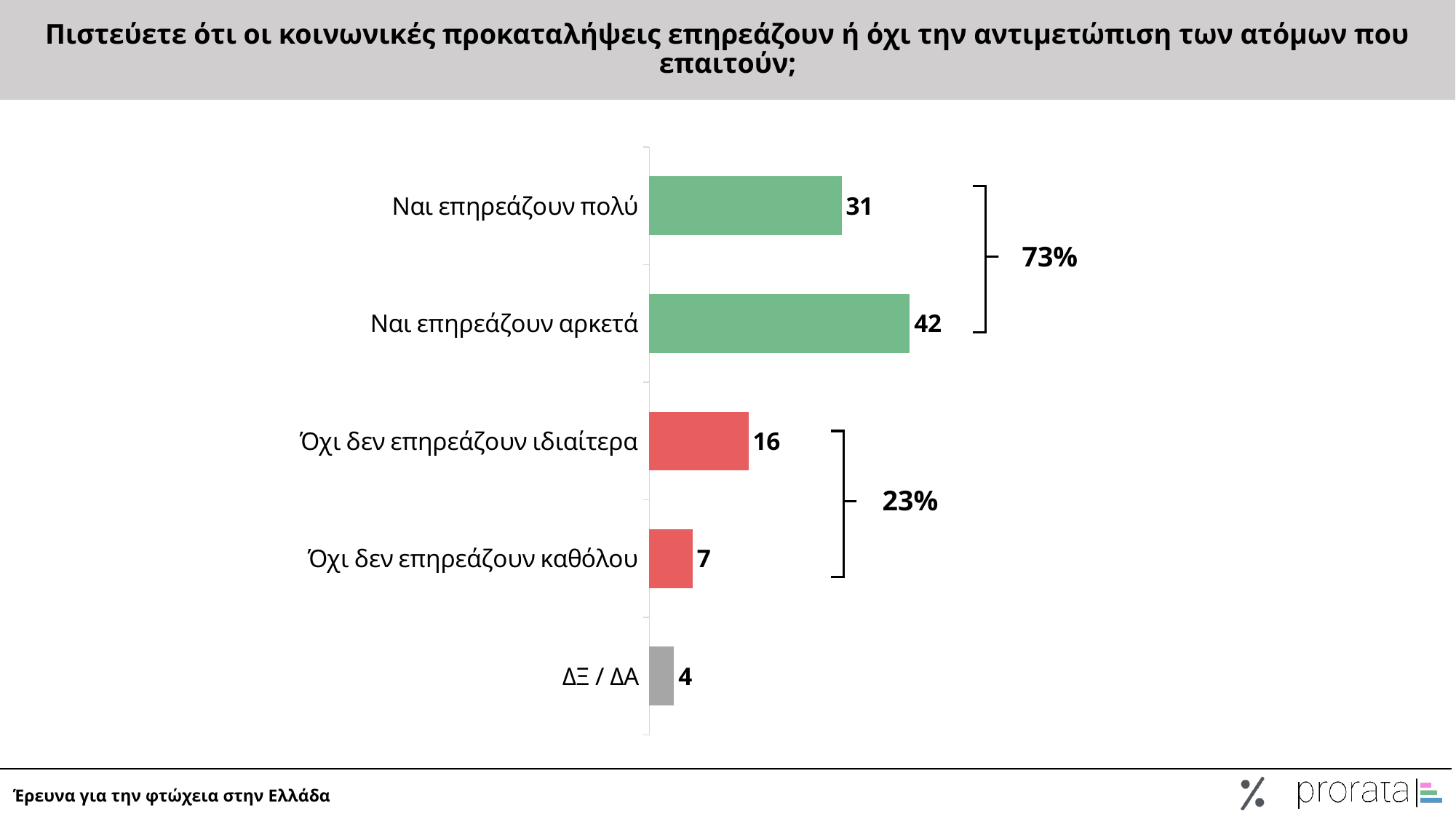
What kind of chart is shown on the slide? Bar chart Which category has the highest value? Ναι επηρεάζουν αρκετά What is the value for 'Όχι δεν επηρεάζουν καθόλου'? 7 What is the value for 'Όχι δεν επηρεάζουν ιδιαίτερα'? 16 How many categories are shown in the chart? 5 What is the value for 'Ναι επηρεάζουν πολύ'? 31 Which category has the lowest value? ΔΞ / ΔΑ What combined percentage is shown by the bracket grouping the two 'Ναι' categories? 73% What is the difference between the values for 'Ναι επηρεάζουν αρκετά' and 'Ναι επηρεάζουν πολύ'? 11 What is the value for 'ΔΞ / ΔΑ'? 4 What is the value for 'Ναι επηρεάζουν αρκετά'? 42 Which is larger, the value for 'Όχι δεν επηρεάζουν ιδιαίτερα' or 'Όχι δεν επηρεάζουν καθόλου'? Όχι δεν επηρεάζουν ιδιαίτερα